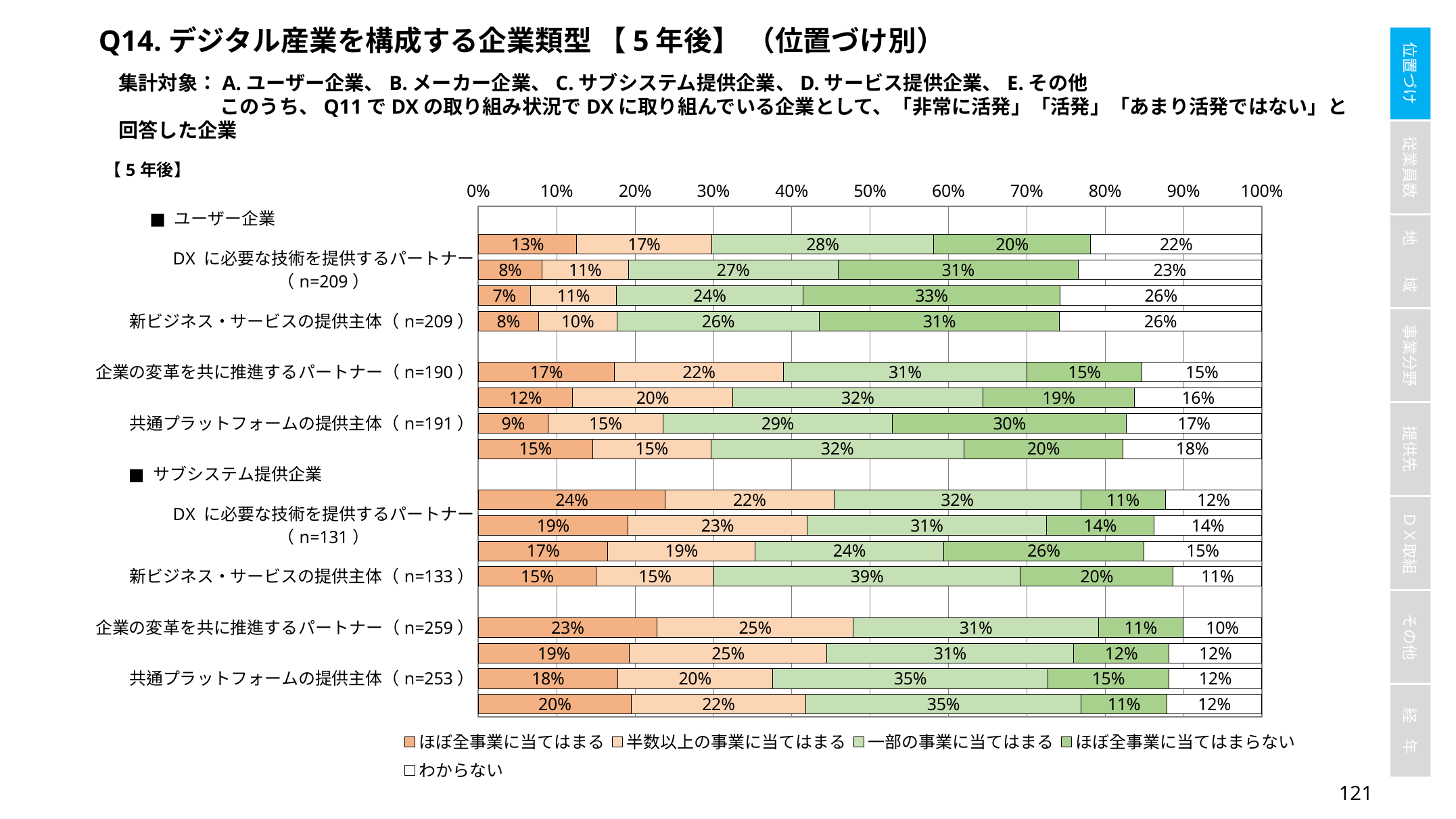
In the bar aligned with the label 共通プラットフォームの提供主体（n=191）under ユーザー企業, what is the value for ほぼ全事業に当てはまらない? 30% In the bar aligned with the label 企業の変革を共に推進するパートナー（n=190）under ユーザー企業, what is the value for 一部の事業に当てはまる? 31% How many stacked bars are plotted in the chart? 16 What is the maximum value shown on the horizontal axis? 100% In the bar aligned with the label 共通プラットフォームの提供主体（n=253）under サブシステム提供企業, which segment is the largest? 一部の事業に当てはまる In the bar aligned with the label 新ビジネス・サービスの提供主体（n=209）under ユーザー企業, what is the value for ほぼ全事業に当てはまる? 8% What kind of chart is shown on the slide? stacked bar chart Which is larger in the bar aligned with 新ビジネス・サービスの提供主体（n=133）under サブシステム提供企業: 一部の事業に当てはまる or ほぼ全事業に当てはまらない? 一部の事業に当てはまる In the bar aligned with the label 企業の変革を共に推進するパートナー（n=259）under サブシステム提供企業, what is the value for わからない? 10% In the bar aligned with the label 新ビジネス・サービスの提供主体（n=133）under サブシステム提供企業, what is the value for 一部の事業に当てはまる? 39% How many series does the legend list? 5 In the bar aligned with the label 企業の変革を共に推進するパートナー（n=190）under ユーザー企業, what is the difference between 半数以上の事業に当てはまる and ほぼ全事業に当てはまる? 5%